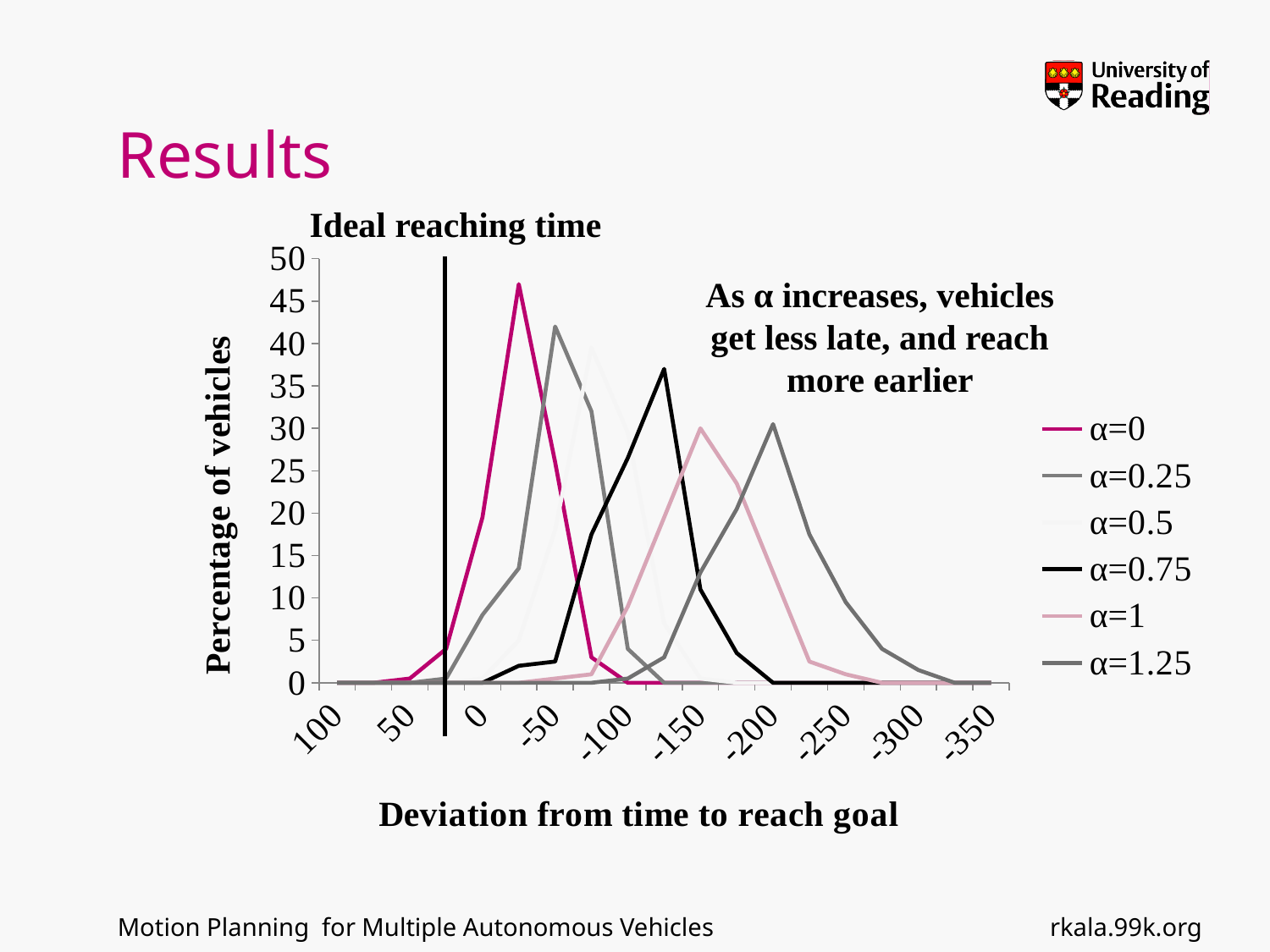
Which series has a higher peak, α=0 or α=0.75? α=0 Is the peak value of the α=0.75 series greater or less than 35? greater Is the peak value of the α=1 series greater or less than 40? less How many series does the legend list? 6 Is the peak value of the α=0.25 series greater or less than 40? greater How many tick labels are shown on the x axis? 10 Which series has a higher peak, α=0.25 or α=1.25? α=0.25 What is the title of the y axis? Percentage of vehicles What kind of chart is shown on the slide? line chart Which series reaches the highest peak percentage of vehicles? α=0 What label is given to the vertical line drawn on the chart? Ideal reaching time